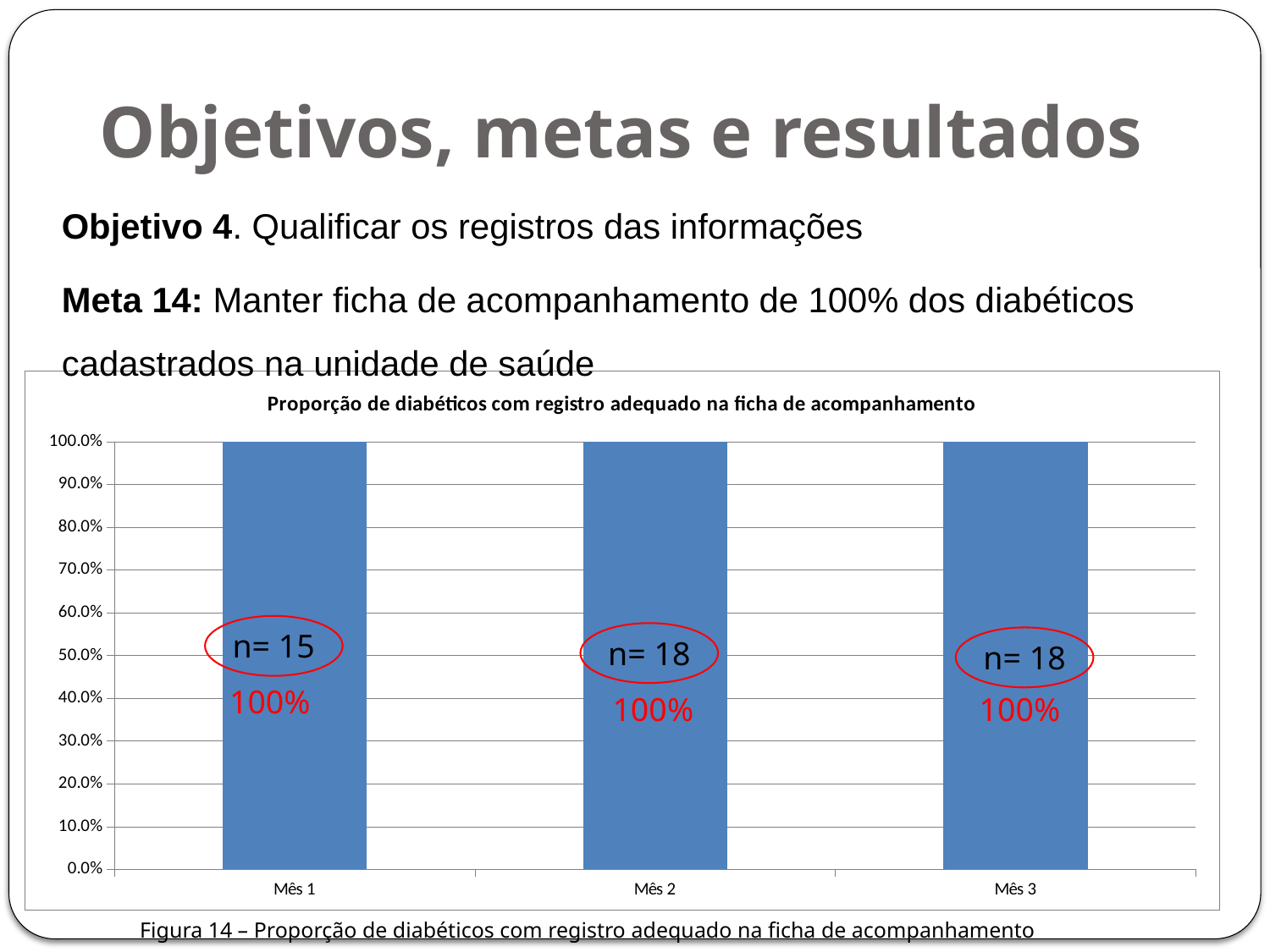
How many categories (months) are plotted on the x axis of the chart? 3 What is the n value annotated on the bar for Mês 3? n= 18 What is the highest tick value shown on the y axis of the chart? 100.0% Is the value for Mês 2 greater or less than 50.0%? greater What is the n value annotated on the bar for Mês 1? n= 15 What is the value shown for Mês 3? 100% What is the value shown for Mês 2? 100% What kind of chart is shown on the slide? bar chart Do the values rise, fall, or stay the same from Mês 1 to Mês 3? stay the same What is the title of the chart? Proporção de diabéticos com registro adequado na ficha de acompanhamento What is the difference between the values for Mês 1 and Mês 3? 0% What is the value shown for Mês 1? 100%